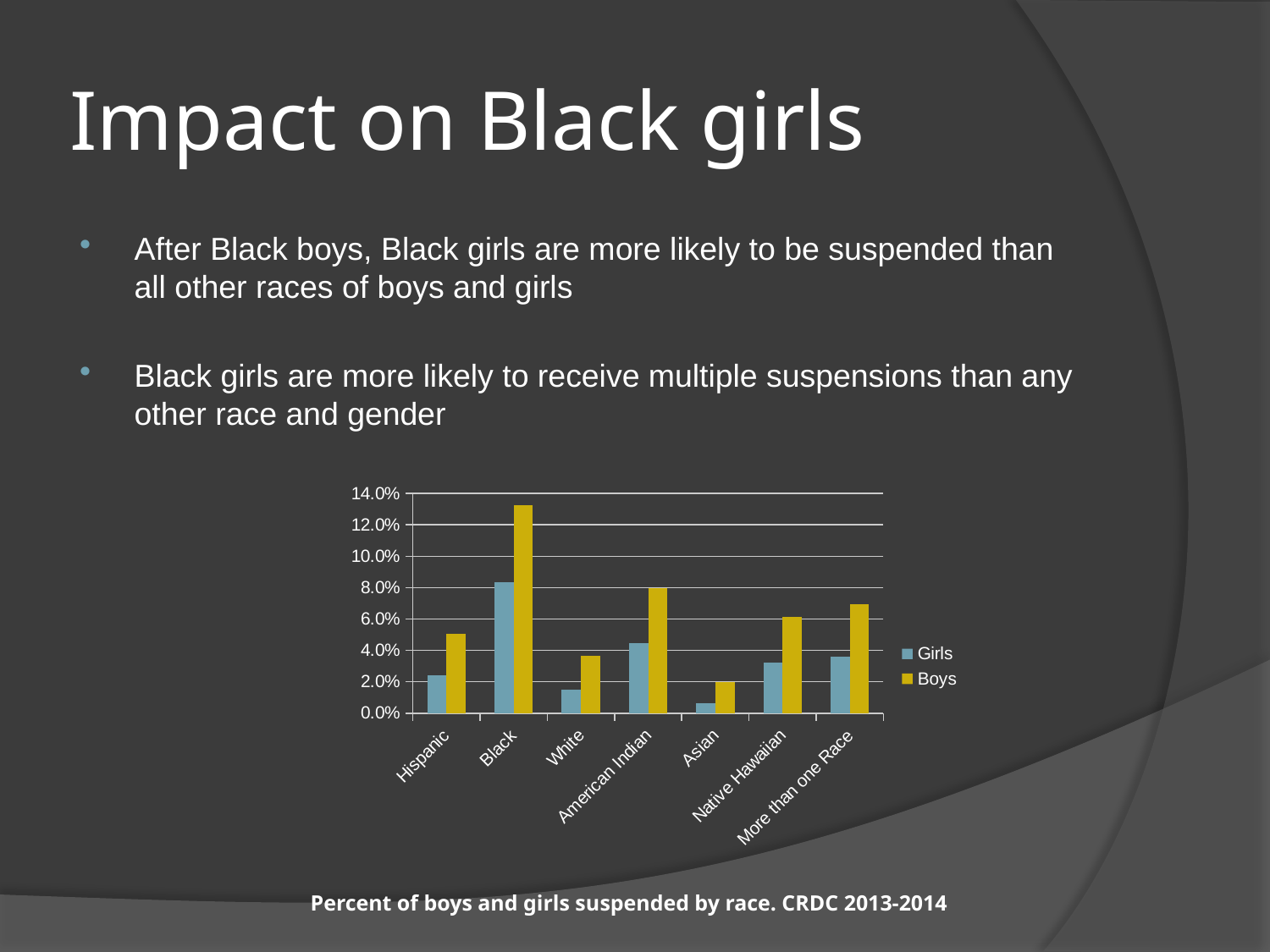
What kind of chart is shown on the slide? bar chart Which race category has the highest value for Girls? Black How many series does the chart's legend list? 2 Is the value for Asian girls greater or less than 2.0%? less Which race category has the lowest value for Girls? Asian Is the value for American Indian boys greater or less than 6.0%? greater Which is larger: the value for American Indian boys or the value for Native Hawaiian boys? American Indian boys Which is larger: the value for Black girls or the value for Hispanic boys? Black girls How many race categories are shown on the x axis of the chart? 7 What are the two entries in the chart's legend? Girls and Boys Which race category has the highest value for Boys? Black Is the value for Black boys greater or less than 12.0%? greater